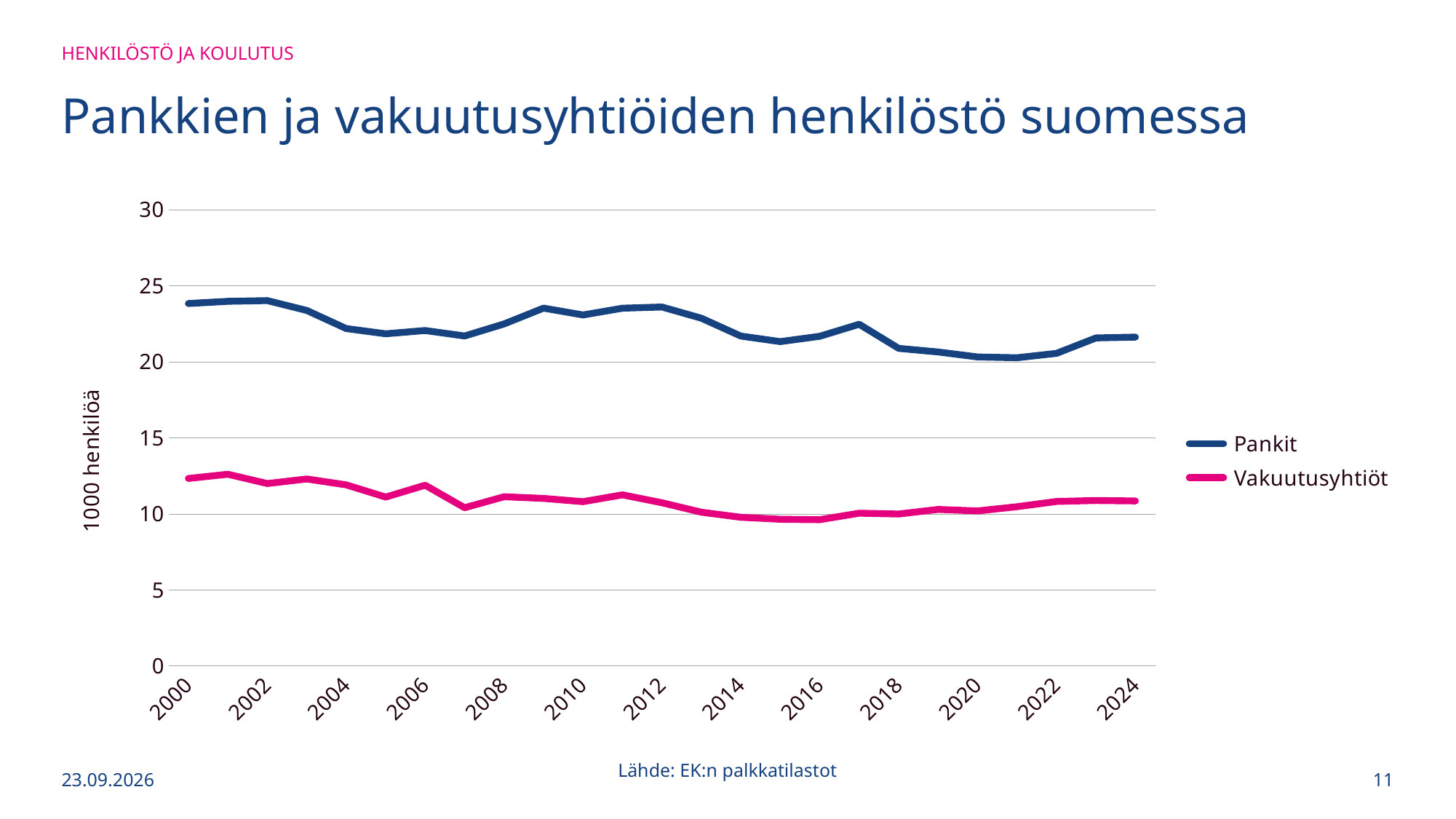
Is the value for Pankit in 2020 greater or less than 25? less Is the value for Pankit in 2000 greater or less than 20? greater What kind of chart is shown on the slide? line chart What is the label on the vertical axis of the chart? 1000 henkilöä What is the title of the chart on the slide? Pankkien ja vakuutusyhtiöiden henkilöstö suomessa Is the value for Vakuutusyhtiöt in 2024 greater or less than 15? less In 2012, which series has the larger value, Pankit or Vakuutusyhtiöt? Pankit How many series does the legend list? 2 Does the Pankit line overall rise or fall from 2000 to 2024? fall Does the Vakuutusyhtiöt line overall rise or fall from 2000 to 2024? fall